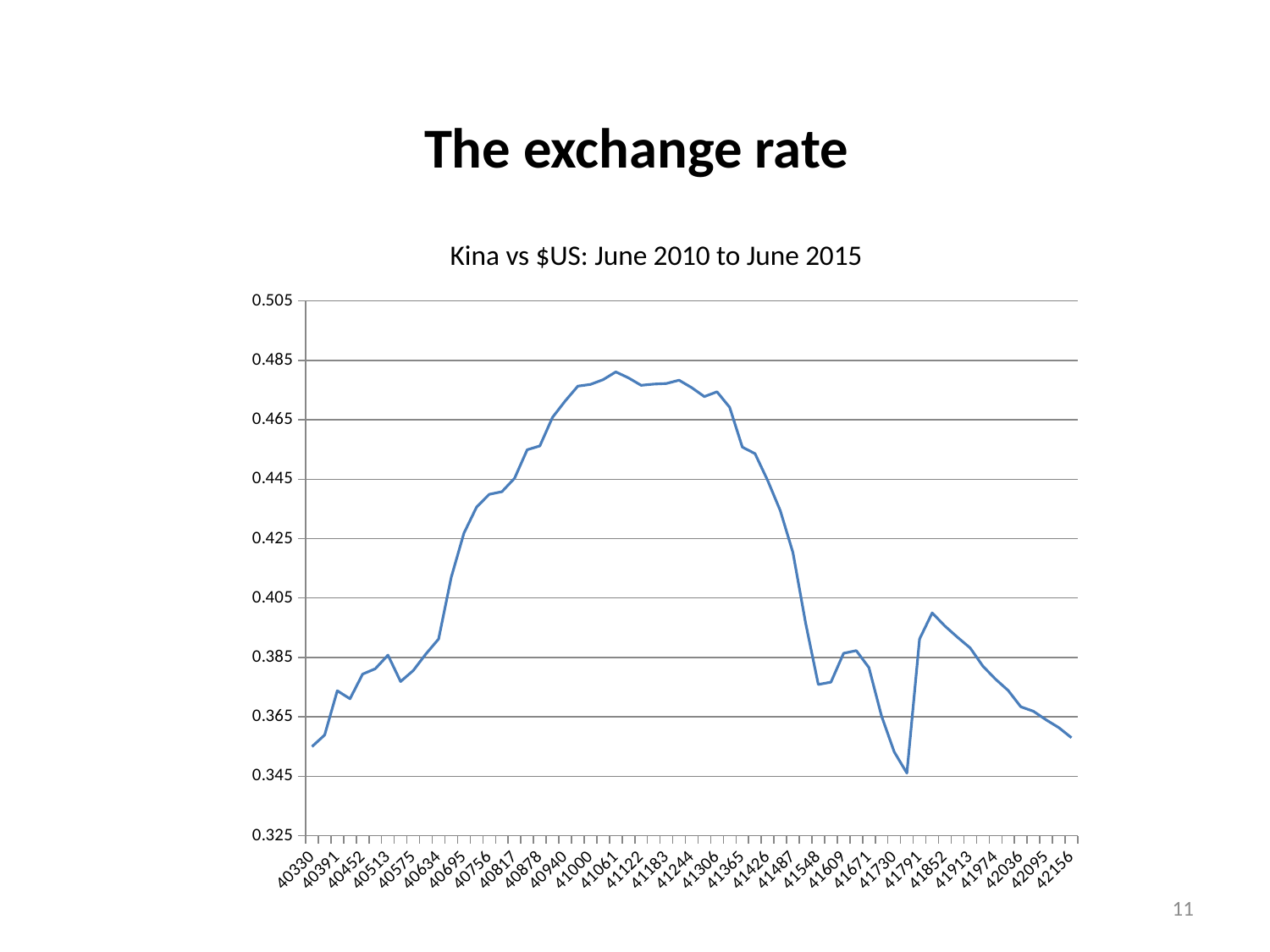
What kind of chart is shown on the slide? line chart Around which x-axis label does the line reach its highest value? 41061 Is the value at 41487 greater or less than 0.445? less Is the value at 41852 greater or less than 0.385? greater Around which x-axis label does the line reach its lowest value? 41791 Does the line rise or fall between 41306 and 41548? fall Is the value at 40756 greater or less than 0.425? greater What is the title of the chart? Kina vs $US: June 2010 to June 2015